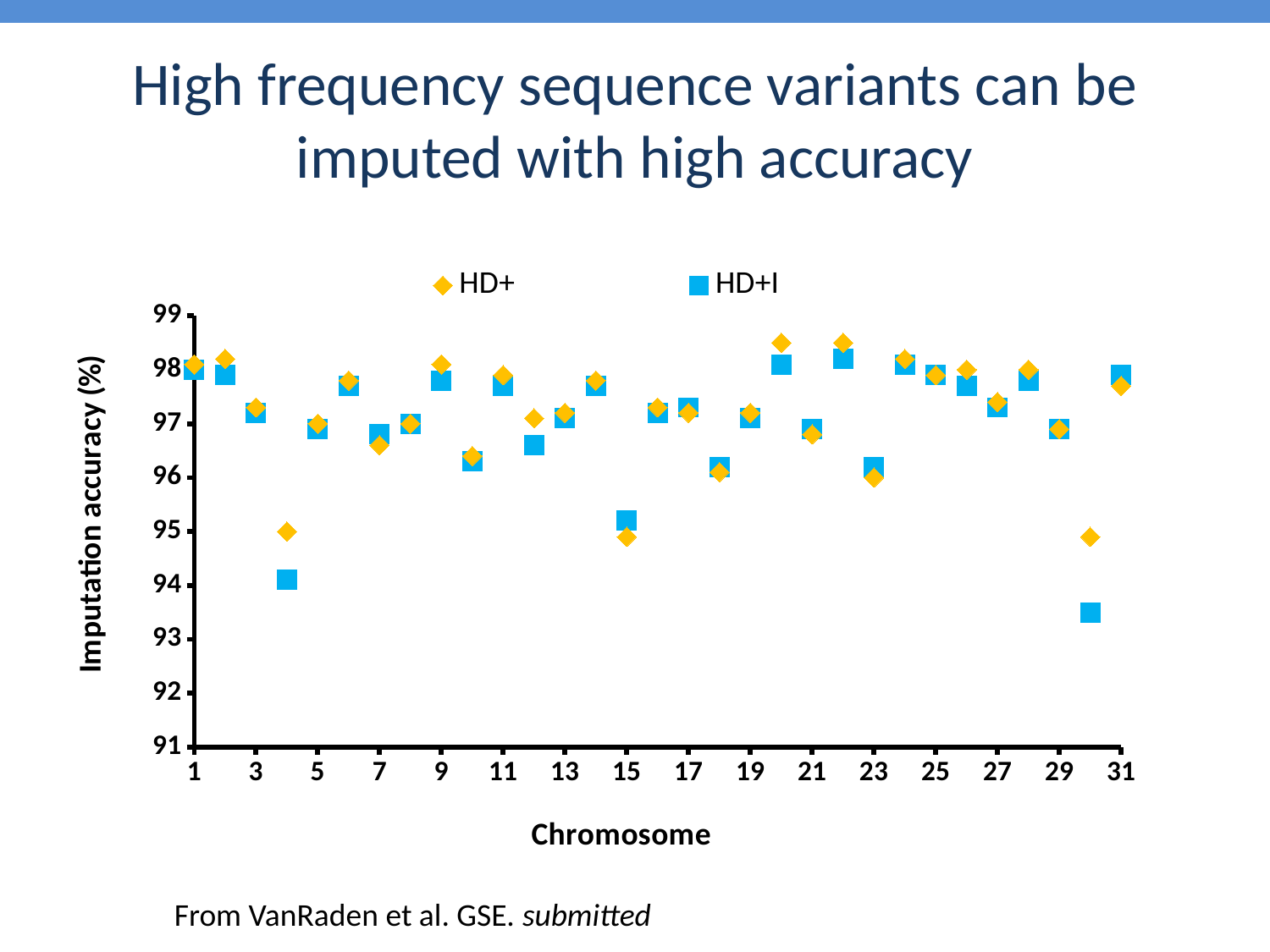
Is the HD+I value for chromosome 4 greater or less than 95? less Is the HD+I value for chromosome 30 greater or less than 94? less How many chromosomes are plotted along the x axis? 31 For chromosome 30, which series has the higher imputation accuracy, HD+ or HD+I? HD+ Is the HD+ value for chromosome 20 greater or less than 98? greater What kind of chart is shown on the slide? Scatter chart How many series does the legend list? 2 For chromosome 4, which series has the higher imputation accuracy, HD+ or HD+I? HD+ What is the title of the y axis? Imputation accuracy (%) Which series is shown with blue square markers? HD+I Which chromosome has the lowest imputation accuracy for the HD+I series? 30